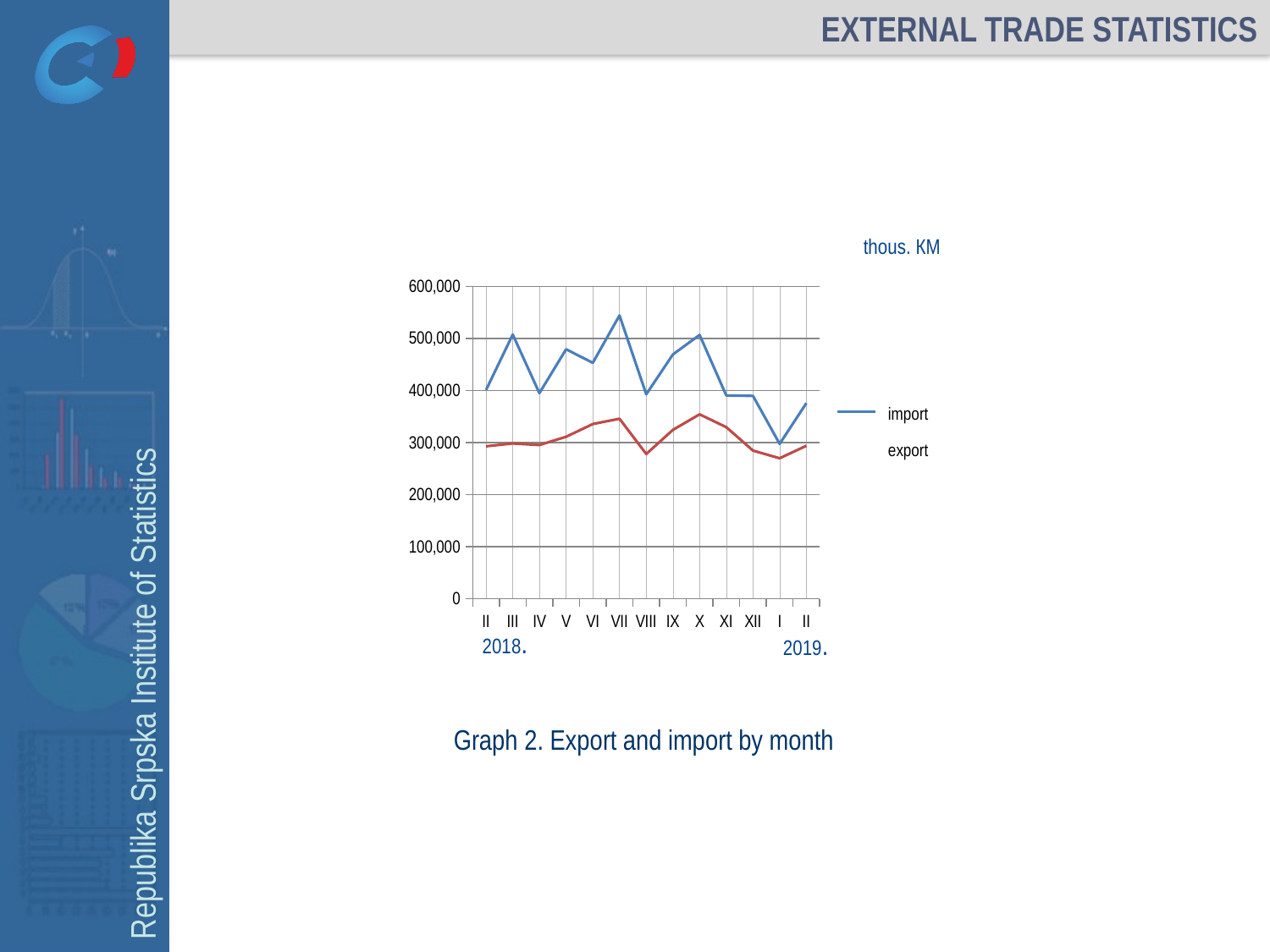
Is the export value for X 2018 greater or less than 300,000? greater What colour is the import line? blue How many months are plotted along the x axis? 13 Is the export value for I 2019 greater or less than 300,000? less Which is larger in VII 2018, import or export? import In which month does the import series reach its highest value? VII 2018 Does the import series rise or fall from VII 2018 to VIII 2018? fall Is the import value for VII 2018 greater or less than 500,000? greater In which month does the import series reach its lowest value? I 2019 What kind of chart is shown on the slide? line chart What unit is stated above the chart? thous. KM How many series does the legend list? 2